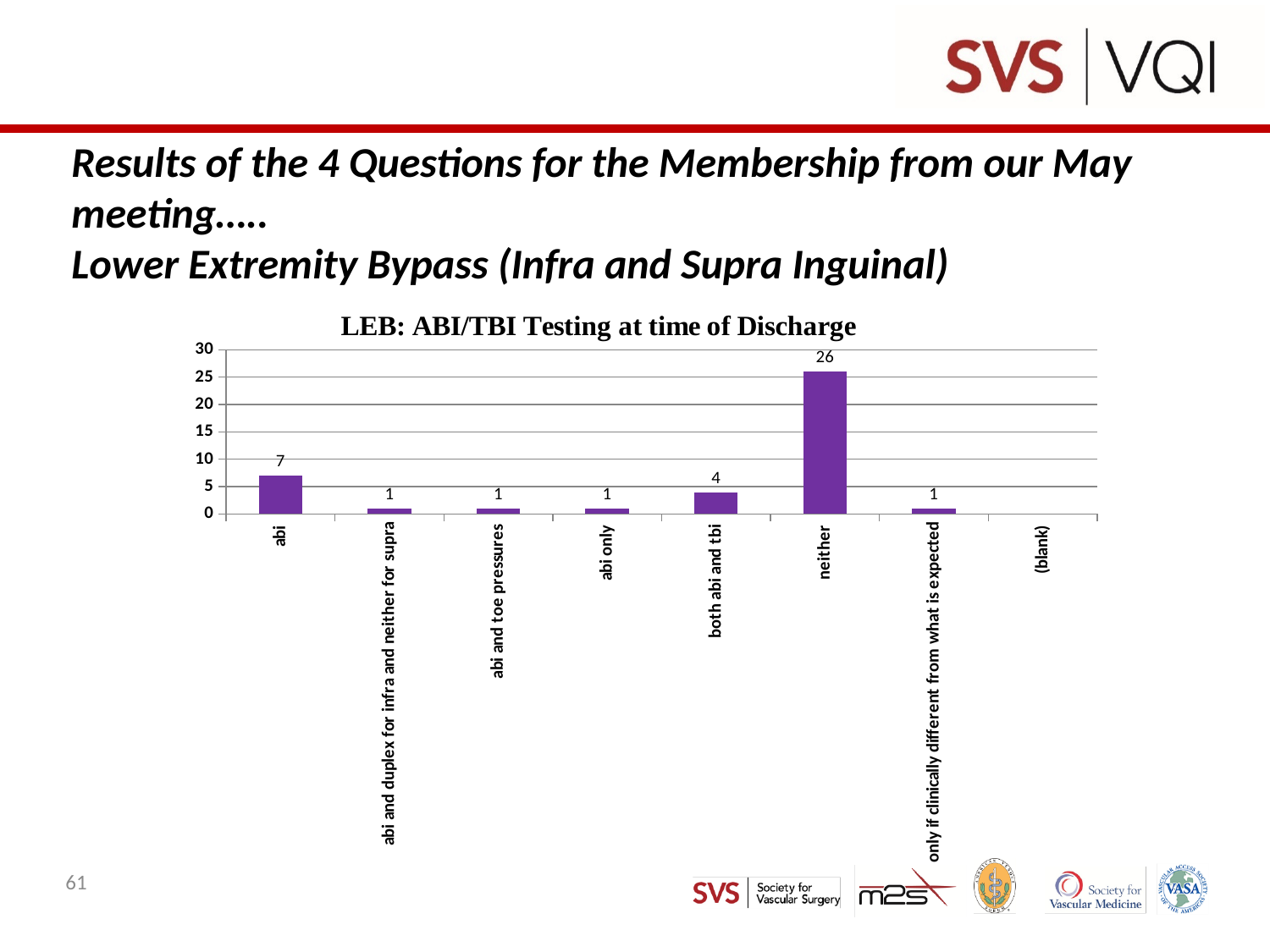
What is the difference between the values for "abi" and "both abi and tbi"? 3 What is the value for "neither"? 26 What is the title of the chart? LEB: ABI/TBI Testing at time of Discharge Is the value for "neither" greater or less than 20? greater What is the value for "abi"? 7 Which is larger, the value for "abi" or the value for "both abi and tbi"? abi What kind of chart is shown? bar chart How many categories are shown on the x axis? 8 What is the difference between the values for "neither" and "abi"? 19 What is the value for "abi only"? 1 Which category has the highest value? neither What is the value for "both abi and tbi"? 4